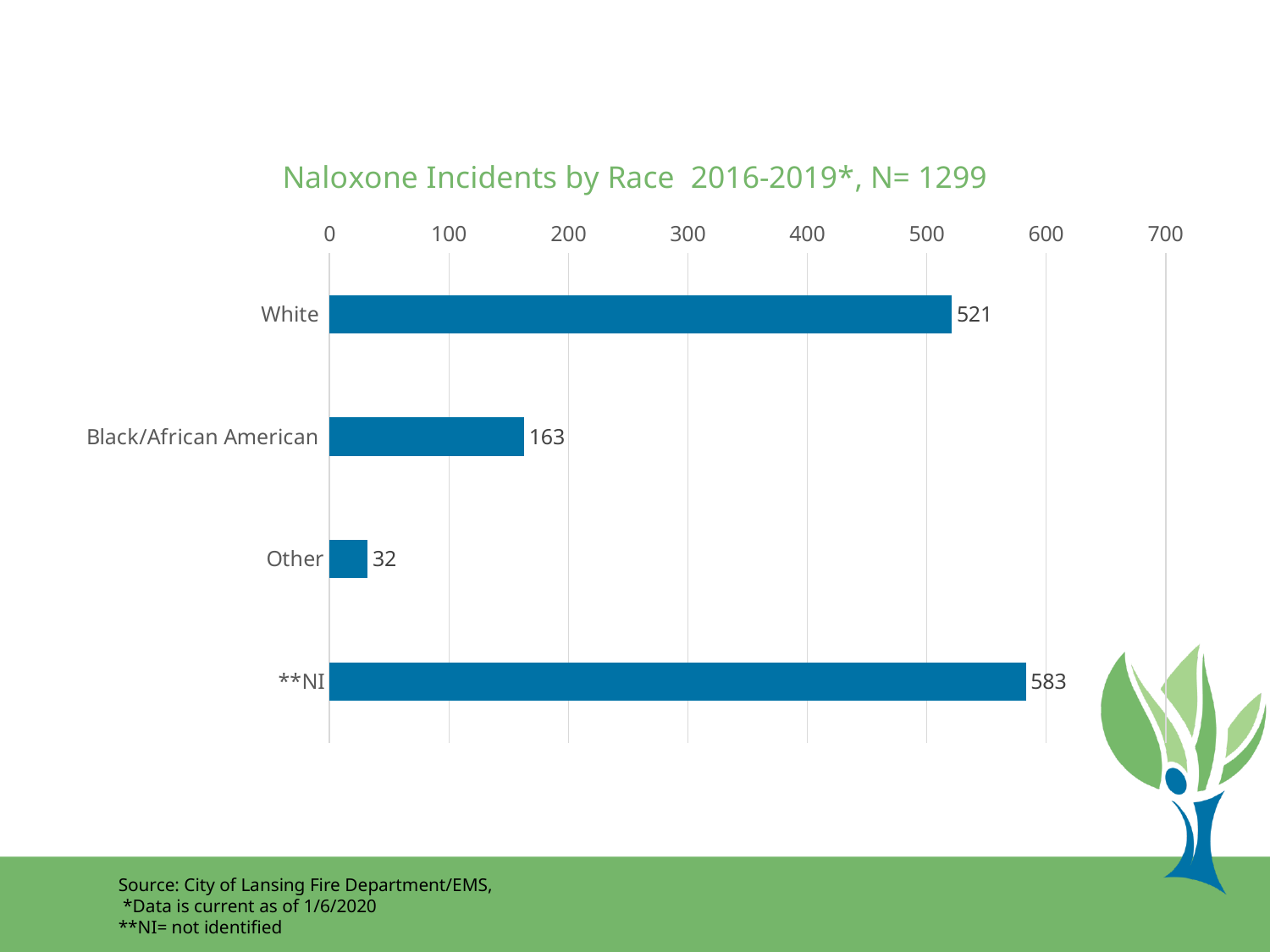
What is the difference between the values for White and Black/African American? 358 What is the difference between the values for **NI and White? 62 What is the title of the chart? Naloxone Incidents by Race 2016-2019*, N= 1299 What is the value for White? 521 Which category has the lowest value? Other What is the value for **NI? 583 What is the value for Other? 32 Which is larger, the value for Black/African American or the value for Other? Black/African American Which category has the highest value? **NI What kind of chart is this? bar chart How many categories are shown in the chart? 4 What is the value for Black/African American? 163